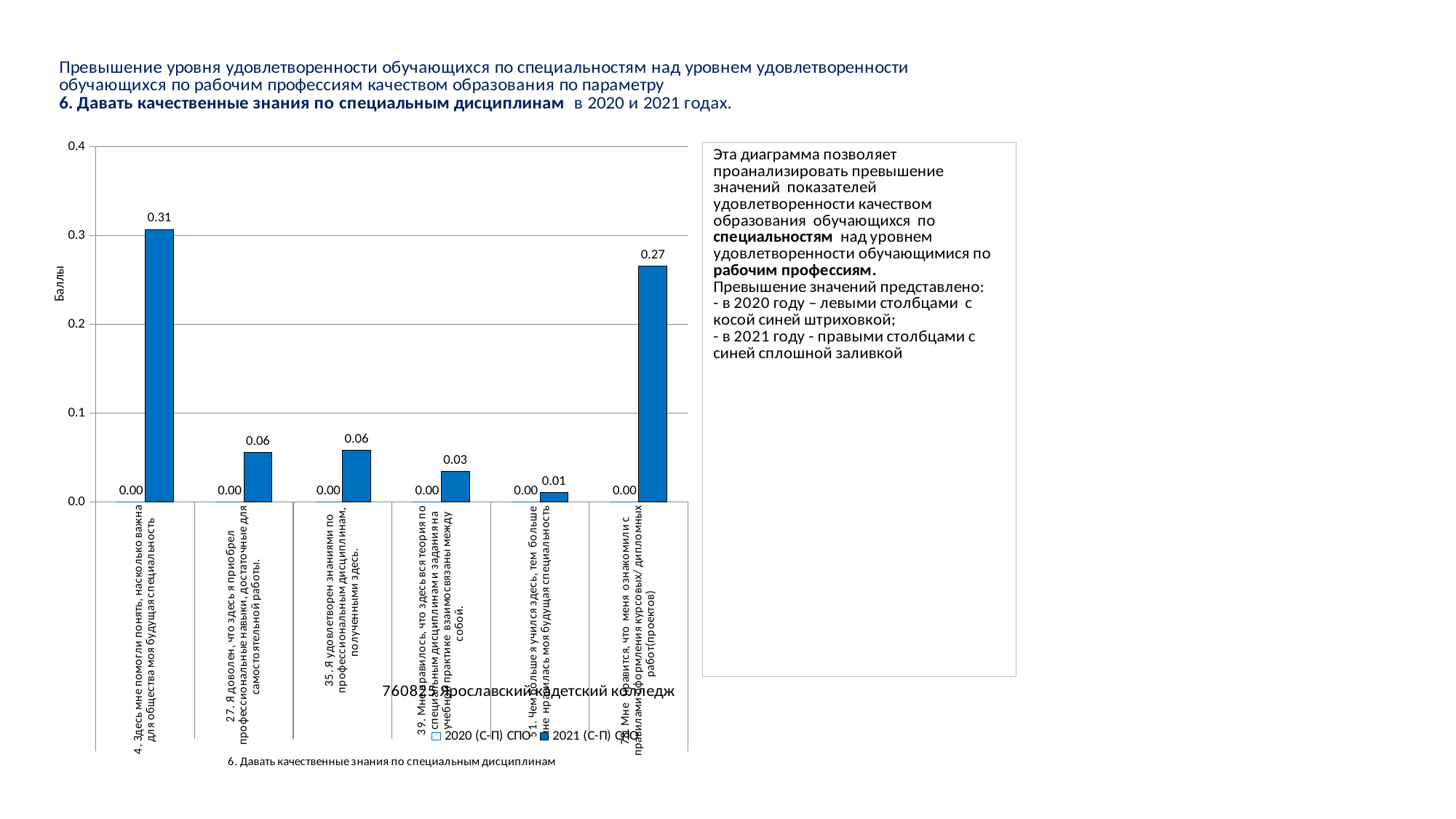
What type of chart is shown on the slide? bar chart What is the 2021 (С-П) СПО value for category 51 ("Чем больше я учился здесь, тем больше мне нравилась моя будущая специальность")? 0.01 What is the 2021 (С-П) СПО value for category 4 ("Здесь мне помогли понять, насколько важна для общества моя будущая специальность")? 0.31 Which category has the lowest 2021 (С-П) СПО value? 51. Чем больше я учился здесь, тем больше мне нравилась моя будущая специальность Which category has the highest 2021 (С-П) СПО value? 4. Здесь мне помогли понять, насколько важна для общества моя будущая специальность What is the 2020 (С-П) СПО value for category 27 ("Я доволен, что здесь я приобрел профессиональные навыки, достаточные для самостоятельной работы")? 0.00 How many categories (questions) are shown on the x axis of the chart? 6 Which is larger: the 2021 (С-П) СПО value for category 39 or for category 35? category 35 How many series does the chart legend list? 2 What is the label of the vertical axis of the chart? Баллы